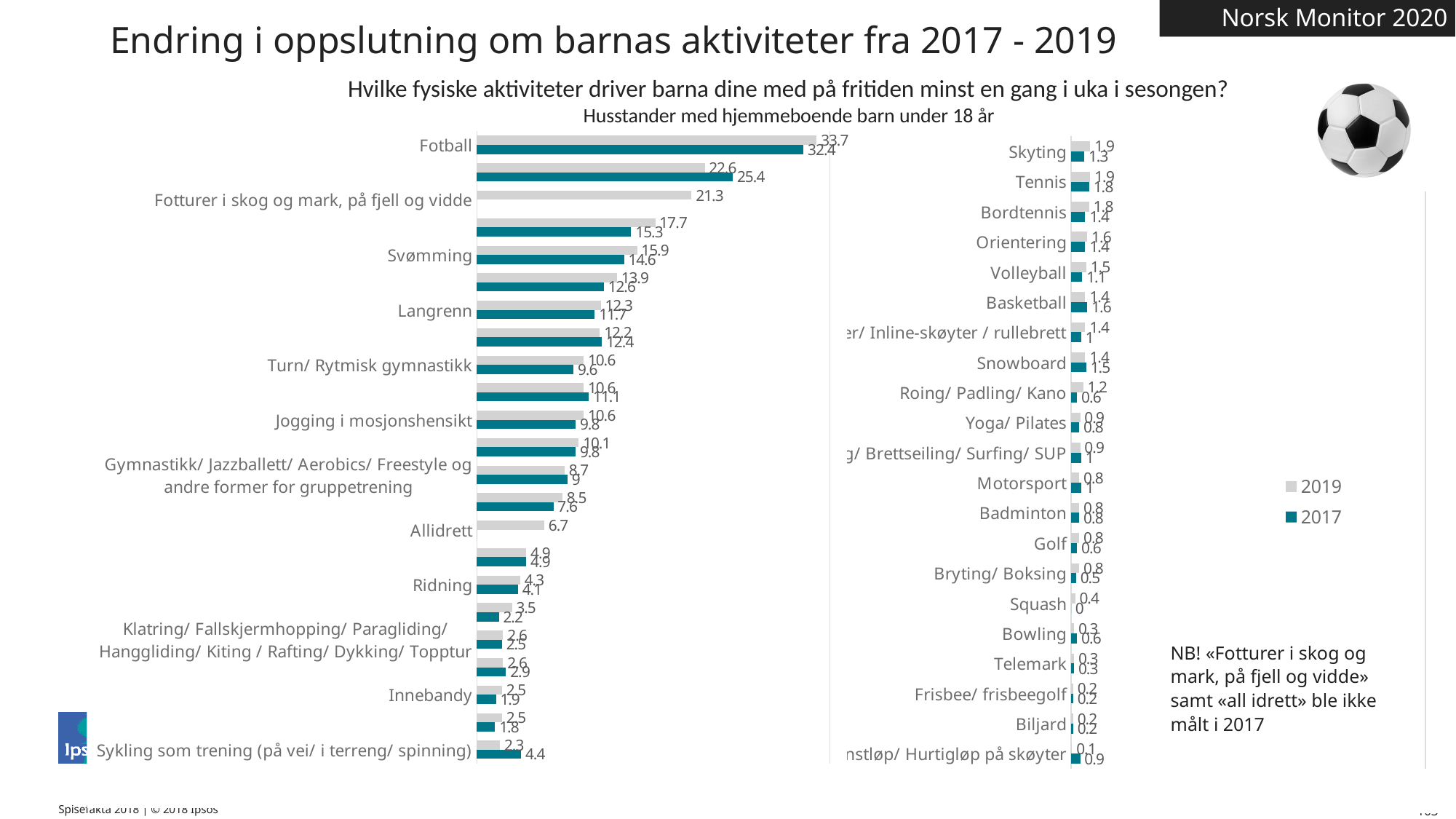
On the left chart, what is the 2019 value for Fotball? 33.7 On the right chart, which is larger for Basketball: the 2019 value or the 2017 value? 2017 On the right chart, which activity has the lowest 2017 value? Squash On the left chart, what is the 2017 value for Svømming? 14.6 On the right chart, what is the 2017 value for Skyting? 1.3 On the right chart, what is the 2019 value for Roing/ Padling/ Kano? 1.2 On the left chart, what is the difference between the 2019 and 2017 values for Fotball? 1.3 On the left chart, which activity has the highest 2019 value? Fotball On the left chart, which is larger for Sykling som trening (på vei/ i terreng/ spinning): the 2019 value or the 2017 value? 2017 What kind of chart is shown on the slide? Bar chart How many series does the legend list? 2 On the left chart, what is the 2019 value for Allidrett? 6.7